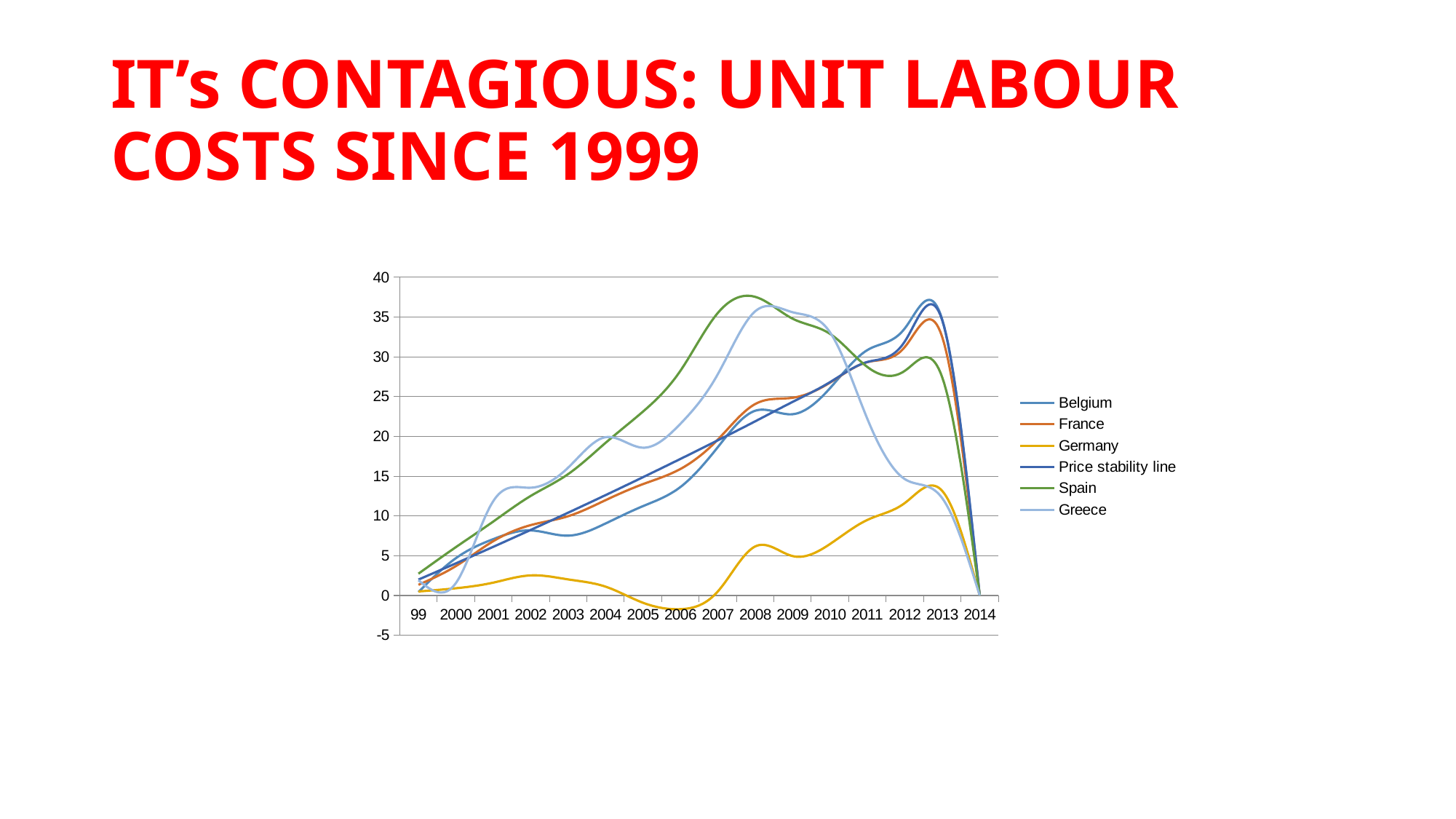
How many series does the legend list? 6 Is the value for Germany in 2008 greater or less than 10? less Which series has the lowest value in 2002? Germany Is the value for Belgium in 2003 greater or less than 10? less In 2012, which is larger: the value for Belgium or the value for Greece? Belgium How many years are labelled along the x axis? 16 Which series has the lowest value in 2010? Germany Which series has the highest value in 2007? Spain Is the value for Spain in 2007 greater or less than 30? greater Does the Greece line rise or fall between 2009 and 2012? fall What kind of chart is shown on the slide? line chart What colour is the Germany line in the legend? yellow